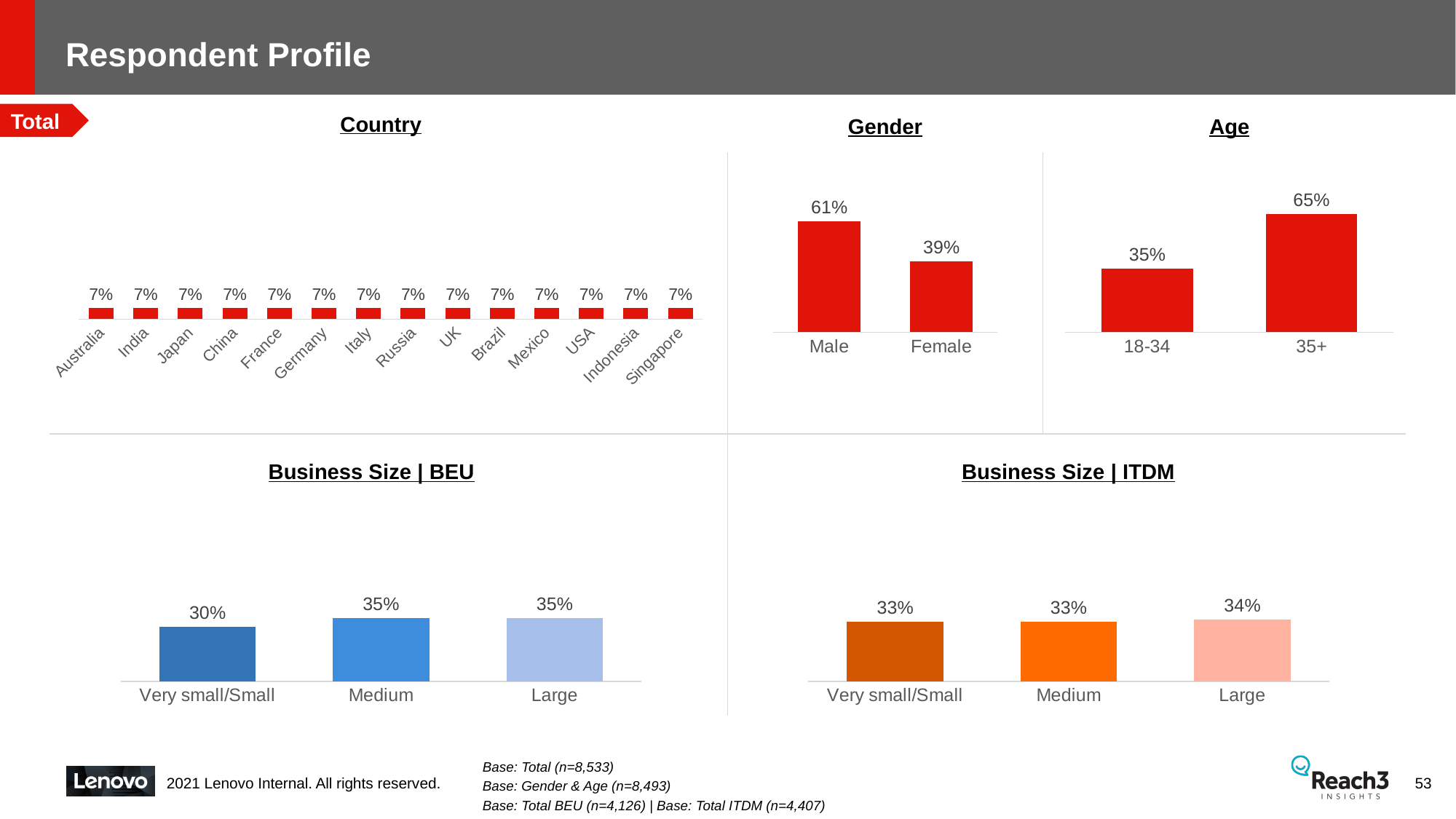
In the Country chart, what is the value for Germany? 7% How many categories are shown in the Business Size | ITDM chart? 3 In the Age chart, which age group has the higher value? 35+ In the Business Size | BEU chart, which category has the lowest value? Very small/Small In the Business Size | ITDM chart, what is the difference between the Large and Medium values? 1% In the Gender chart, what is the difference between the Male and Female values? 22% In the Business Size | BEU chart, what is the value for Very small/Small? 30% In the Business Size | ITDM chart, what is the value for Large? 34% In the Gender chart, what is the value for Male? 61% In the Age chart, what is the value for 35+? 65% What type of chart is the Gender chart? Bar chart How many countries are shown in the Country chart? 14